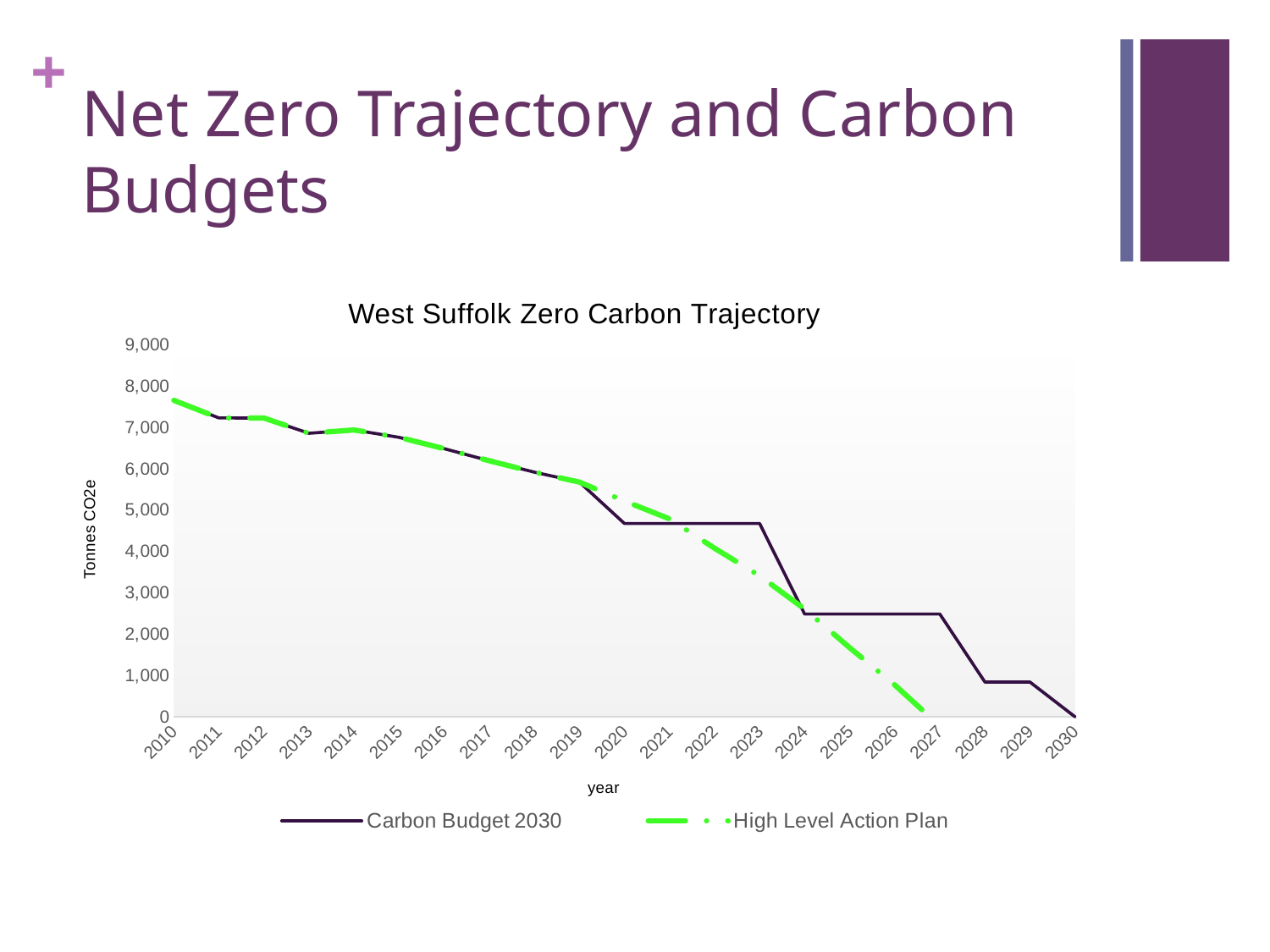
Is the value for High Level Action Plan in 2025 greater or less than 3,000? less What is the label on the vertical axis of the chart? Tonnes CO2e What is the title of the chart? West Suffolk Zero Carbon Trajectory Is the value for Carbon Budget 2030 in 2028 greater or less than 1,000? less How many series does the chart legend list? 2 Is the value for Carbon Budget 2030 in 2020 greater or less than 5,000? less Do the values of the Carbon Budget 2030 series rise or fall from 2010 to 2030? fall What kind of chart is shown on the slide? line chart How many years are shown along the x axis of the chart? 21 In 2026, which series has the higher value: Carbon Budget 2030 or High Level Action Plan? Carbon Budget 2030 What is the value of the Carbon Budget 2030 series in 2030? 0